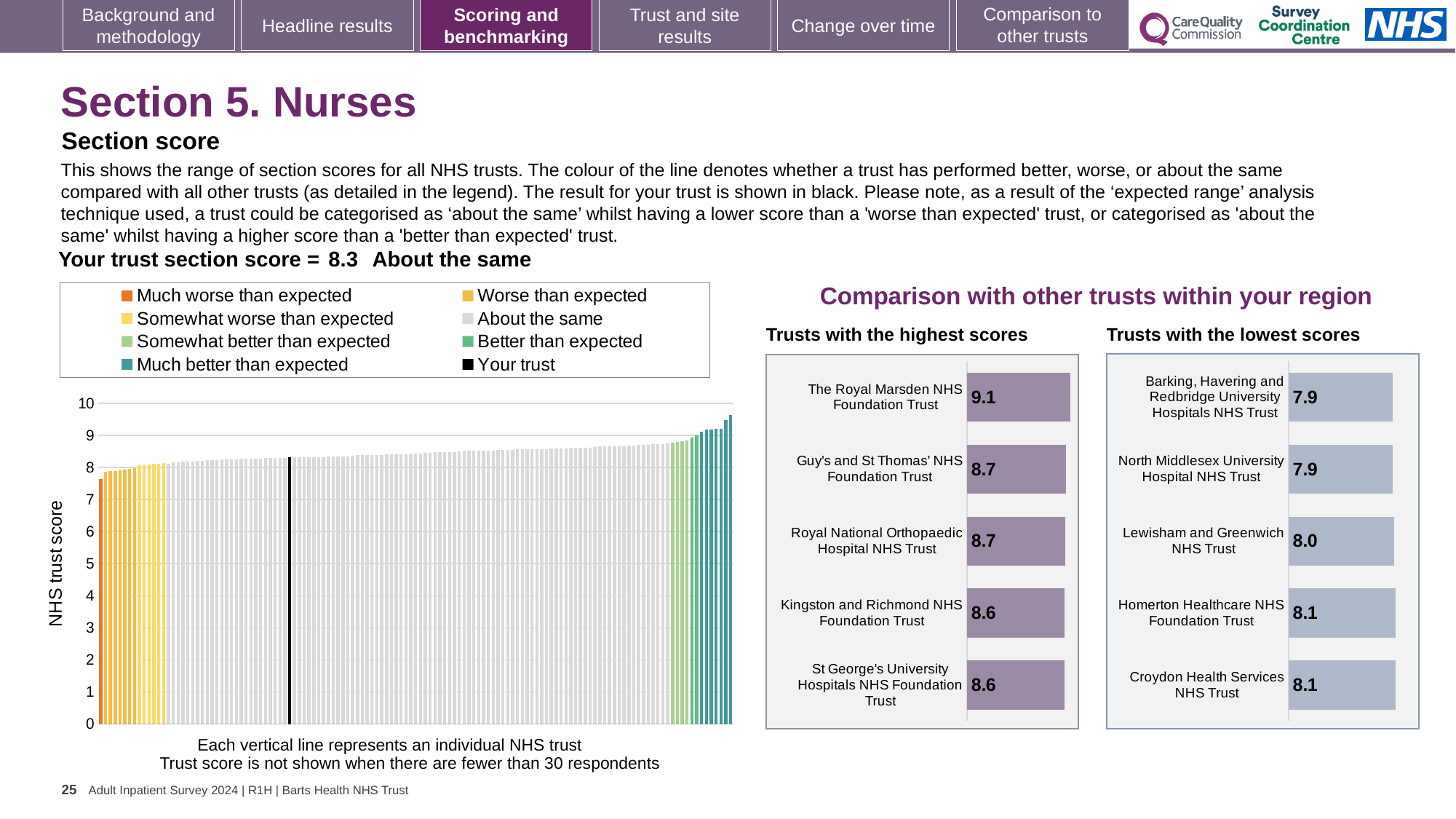
In the 'Trusts with the highest scores' chart, what is the score for The Royal Marsden NHS Foundation Trust? 9.1 How many trusts are shown in the 'Trusts with the highest scores' chart? 5 What kind of chart is the large 'NHS trust score' chart on the left of the slide? Bar chart In the large 'NHS trust score' chart on the left, do the values rise or fall from left to right? Rise How many entries does the legend of the large 'NHS trust score' chart on the left list? 8 In the 'Trusts with the lowest scores' chart, what is the score for North Middlesex University Hospital NHS Trust? 7.9 In the 'Trusts with the lowest scores' chart, which has the larger score: Lewisham and Greenwich NHS Trust or Homerton Healthcare NHS Foundation Trust? Homerton Healthcare NHS Foundation Trust In the 'Trusts with the lowest scores' chart, what is the score for Lewisham and Greenwich NHS Trust? 8.0 In the 'Trusts with the highest scores' chart, what is the score for Kingston and Richmond NHS Foundation Trust? 8.6 In the 'Trusts with the highest scores' chart, what is the difference between the scores of The Royal Marsden NHS Foundation Trust and St George's University Hospitals NHS Foundation Trust? 0.5 In the 'Trusts with the lowest scores' chart, what is the difference between the scores of Croydon Health Services NHS Trust and Barking, Havering and Redbridge University Hospitals NHS Trust? 0.2 In the 'Trusts with the highest scores' chart, which trust has the highest score? The Royal Marsden NHS Foundation Trust